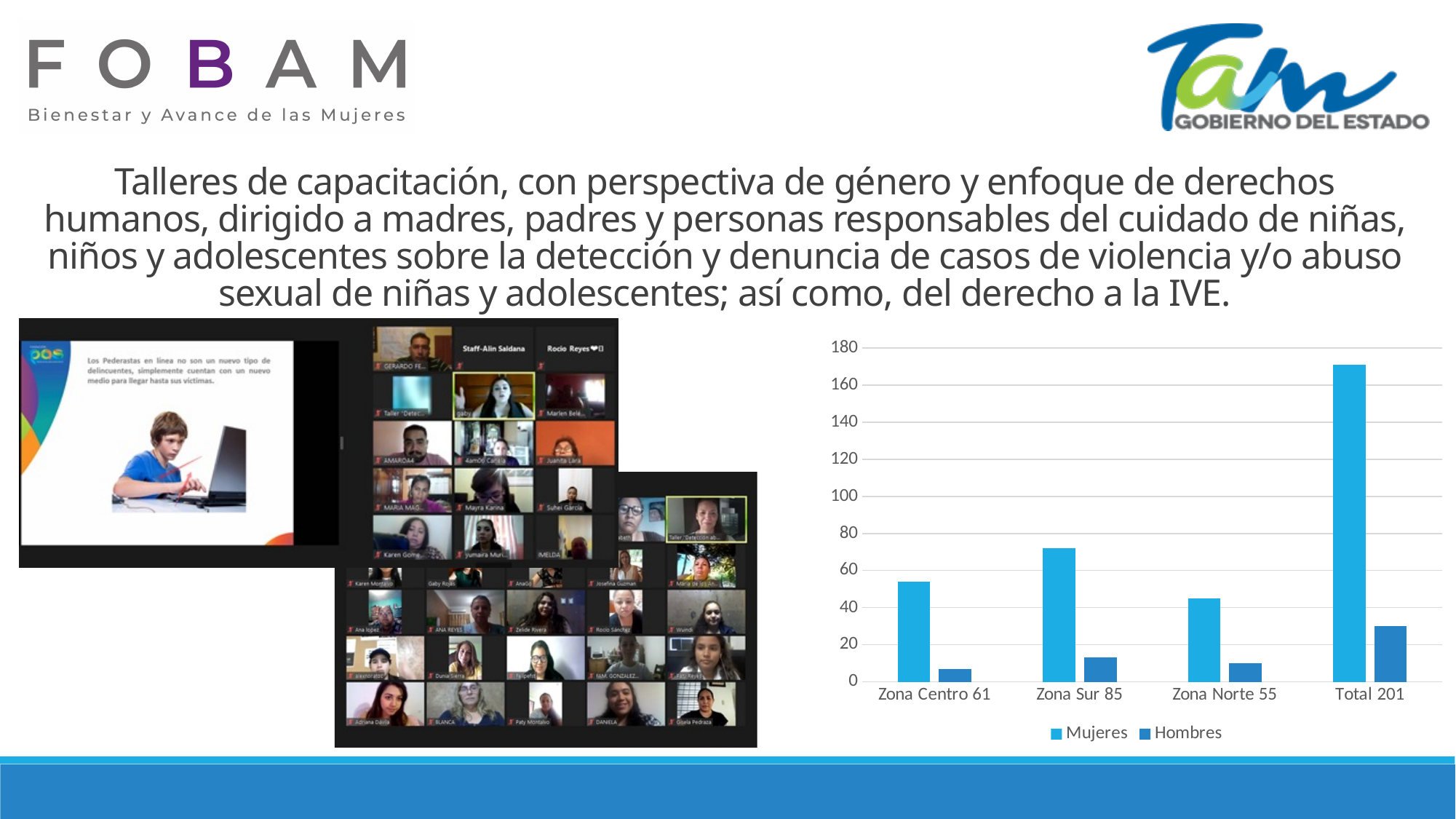
Which category has the lowest Hombres bar? Zona Centro 61 Is the Mujeres bar for Zona Sur 85 greater or less than 60? greater Among the three zones (excluding Total), which has the lowest Mujeres bar? Zona Norte 55 Is the Hombres bar for Zona Sur 85 greater or less than 20? less Which is larger for Zona Centro 61: the Mujeres bar or the Hombres bar? Mujeres Is the Mujeres bar for Total 201 greater or less than 160? greater How many series does the chart legend list? 2 What are the two series named in the chart legend? Mujeres and Hombres How many categories are shown along the x axis of the chart? 4 What kind of chart is shown on the right side of the slide? bar chart Which category has the highest Mujeres bar? Total 201 Among the three zones (excluding Total), which has the highest Mujeres bar? Zona Sur 85